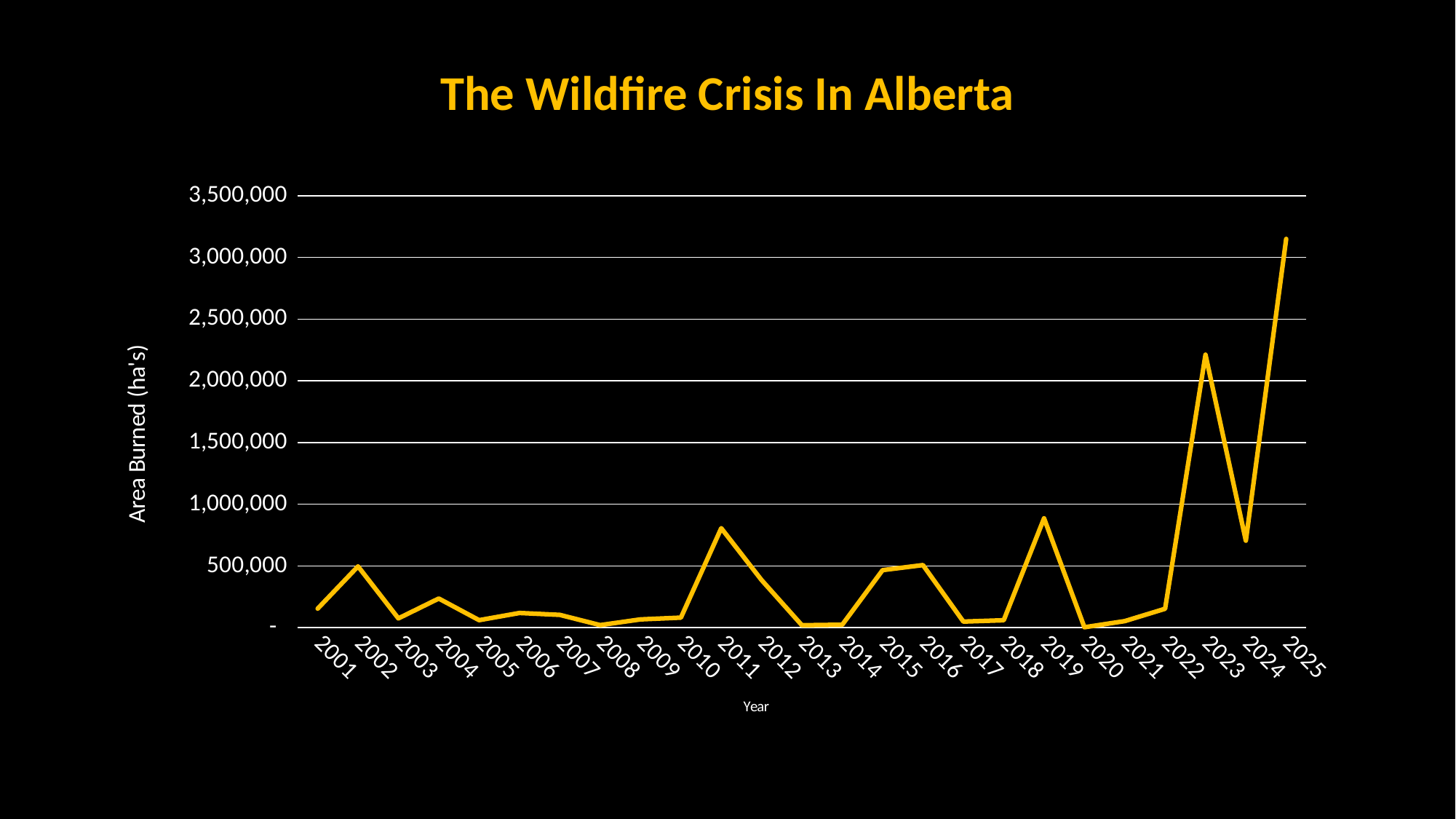
Is the area burned in 2023 greater or less than 2,000,000? greater Does the area burned rise or fall from 2022 to 2023? rise Which year has the highest area burned? 2025 What is the label on the vertical axis of the chart? Area Burned (ha's) Which year had a larger area burned, 2002 or 2003? 2002 How many years are plotted along the x axis of the chart? 25 Is the area burned in 2025 greater or less than 3,000,000? greater Is the area burned in 2024 greater or less than 1,000,000? less Which year had a larger area burned, 2023 or 2024? 2023 What is the title of the chart? The Wildfire Crisis In Alberta What kind of chart is shown on the slide? Line chart